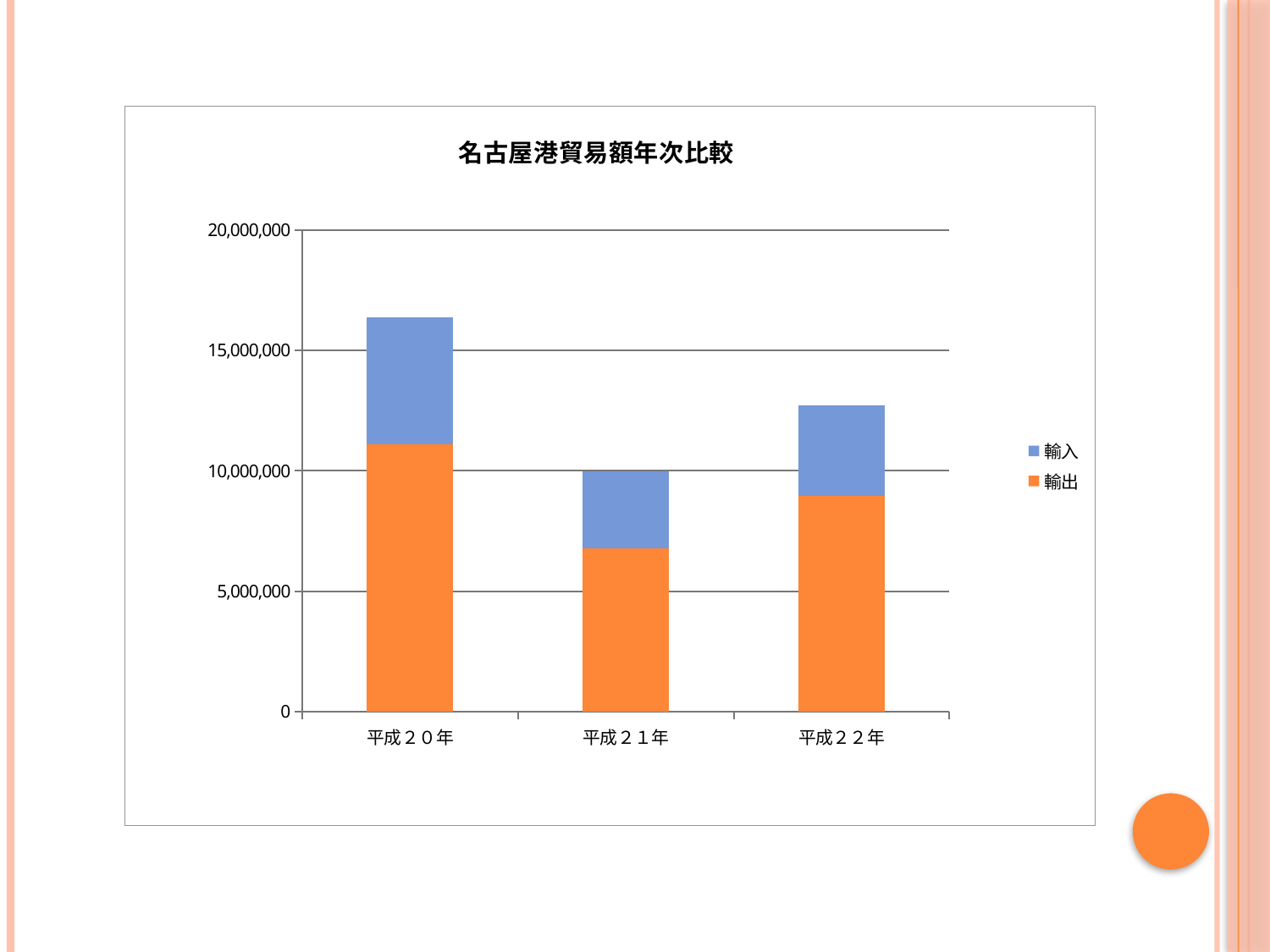
Which year has the larger 輸出 value, 平成２０年 or 平成２２年? 平成２０年 Which year has the highest total bar? 平成２０年 Which year has the lowest total bar? 平成２１年 How many categories (years) are shown on the x axis? 3 Is the total bar for 平成２０年 greater or less than 15,000,000? greater What kind of chart is shown on the slide? Stacked bar chart Is the total bar for 平成２２年 greater or less than 10,000,000? greater How many series does the legend list? 2 What is the title of the chart? 名古屋港貿易額年次比較 Which colour represents 輸入 in the legend? Blue Is the 輸出 value for 平成２１年 greater or less than 5,000,000? greater